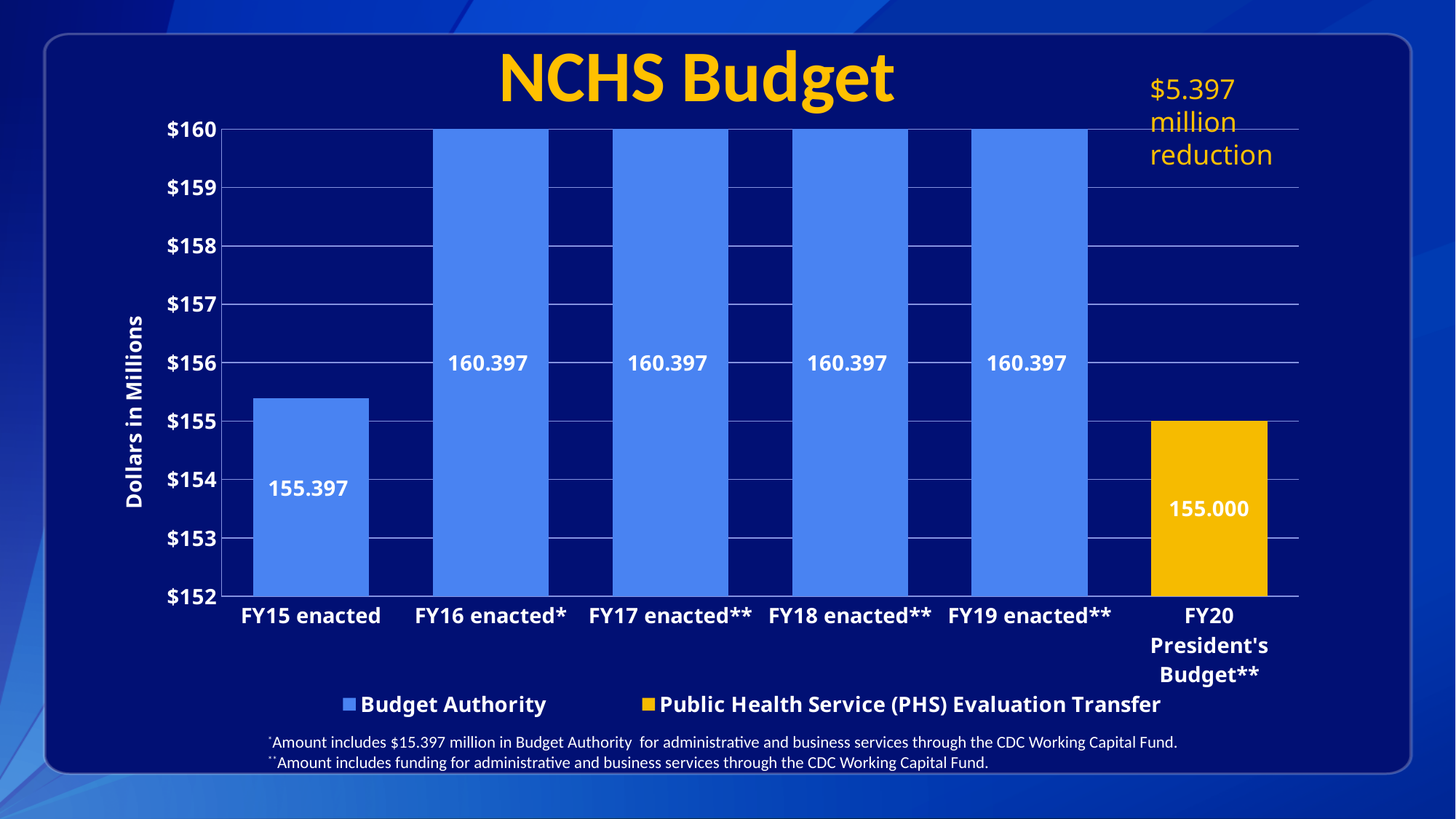
How many series does the legend list? 2 What is the title of the chart? NCHS Budget What is the difference between the FY19 enacted** value and the FY20 President's Budget** value? 5.397 How many categories are shown on the x axis? 6 What is the value for FY20 President's Budget**? 155.000 Which is larger, the value for FY15 enacted or the value for FY20 President's Budget**? FY15 enacted What is the difference between the FY16 enacted* value and the FY15 enacted value? 5.000 What is the value for FY15 enacted? 155.397 Which category has the lowest value? FY20 President's Budget** What is the value for FY17 enacted**? 160.397 What kind of chart is shown? bar chart Is the value for FY18 enacted** greater or less than $158? greater